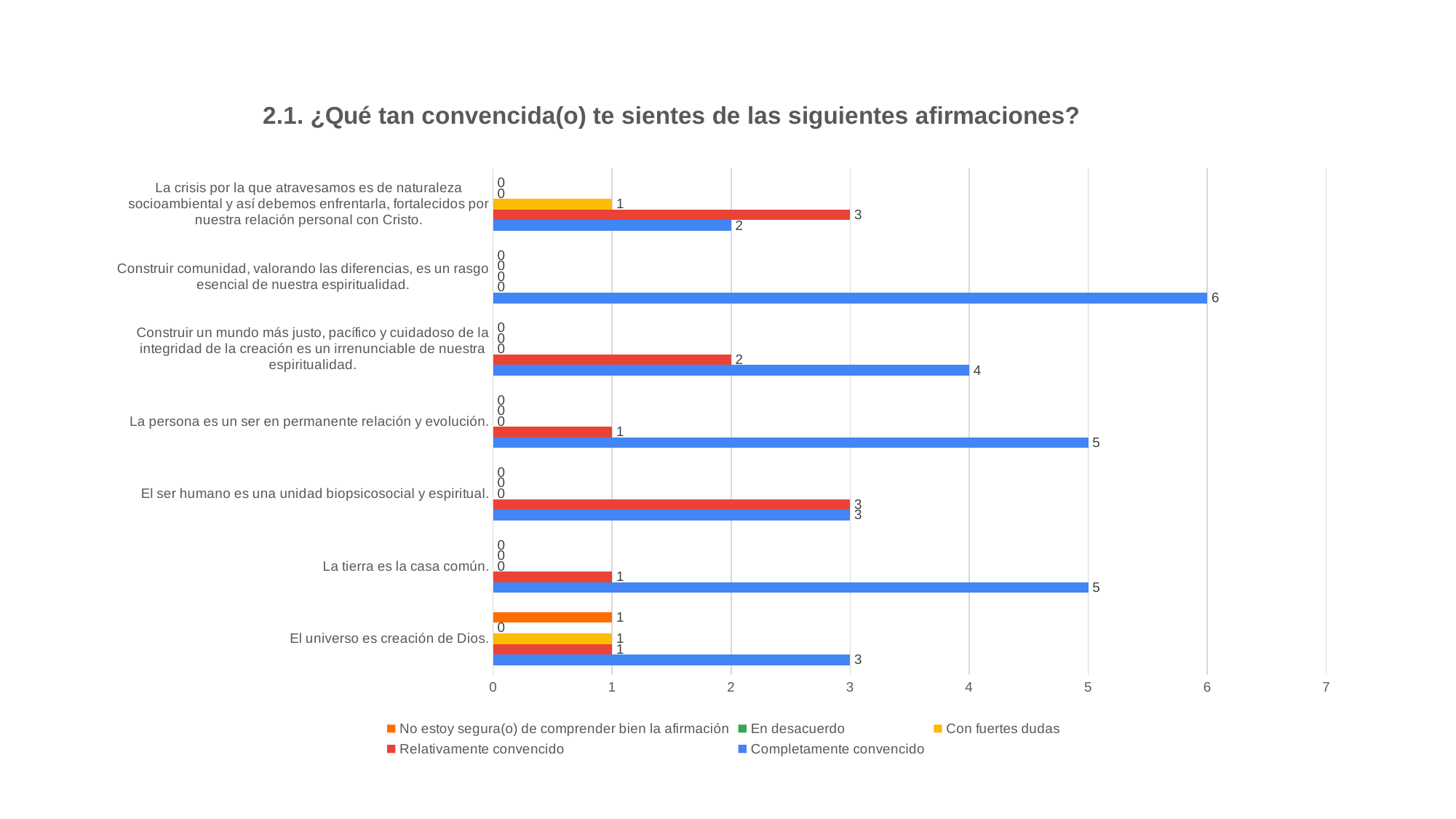
What is the title of the chart? 2.1. ¿Qué tan convencida(o) te sientes de las siguientes afirmaciones? How many series does the legend list? 5 For "La persona es un ser en permanente relación y evolución.", which is larger: "Completamente convencido" or "Relativamente convencido"? Completamente convencido Which statement has the lowest value for "Completamente convencido"? La crisis por la que atravesamos es de naturaleza socioambiental y así debemos enfrentarla, fortalecidos por nuestra relación personal con Cristo. What is the value of "Con fuertes dudas" for "El universo es creación de Dios."? 1 What is the value of "Relativamente convencido" for "La crisis por la que atravesamos es de naturaleza socioambiental y así debemos enfrentarla, fortalecidos por nuestra relación personal con Cristo."? 3 How many statements (categories) are shown on the chart? 7 What kind of chart is shown on the slide? Bar chart What is the difference between "Completamente convencido" and "Relativamente convencido" for "Construir un mundo más justo, pacífico y cuidadoso de la integridad de la creación es un irrenunciable de nuestra espiritualidad."? 2 What is the value of "Completamente convencido" for "Construir comunidad, valorando las diferencias, es un rasgo esencial de nuestra espiritualidad."? 6 Which statement has the highest value for "Completamente convencido"? Construir comunidad, valorando las diferencias, es un rasgo esencial de nuestra espiritualidad. What is the value of "No estoy segura(o) de comprender bien la afirmación" for "El universo es creación de Dios."? 1